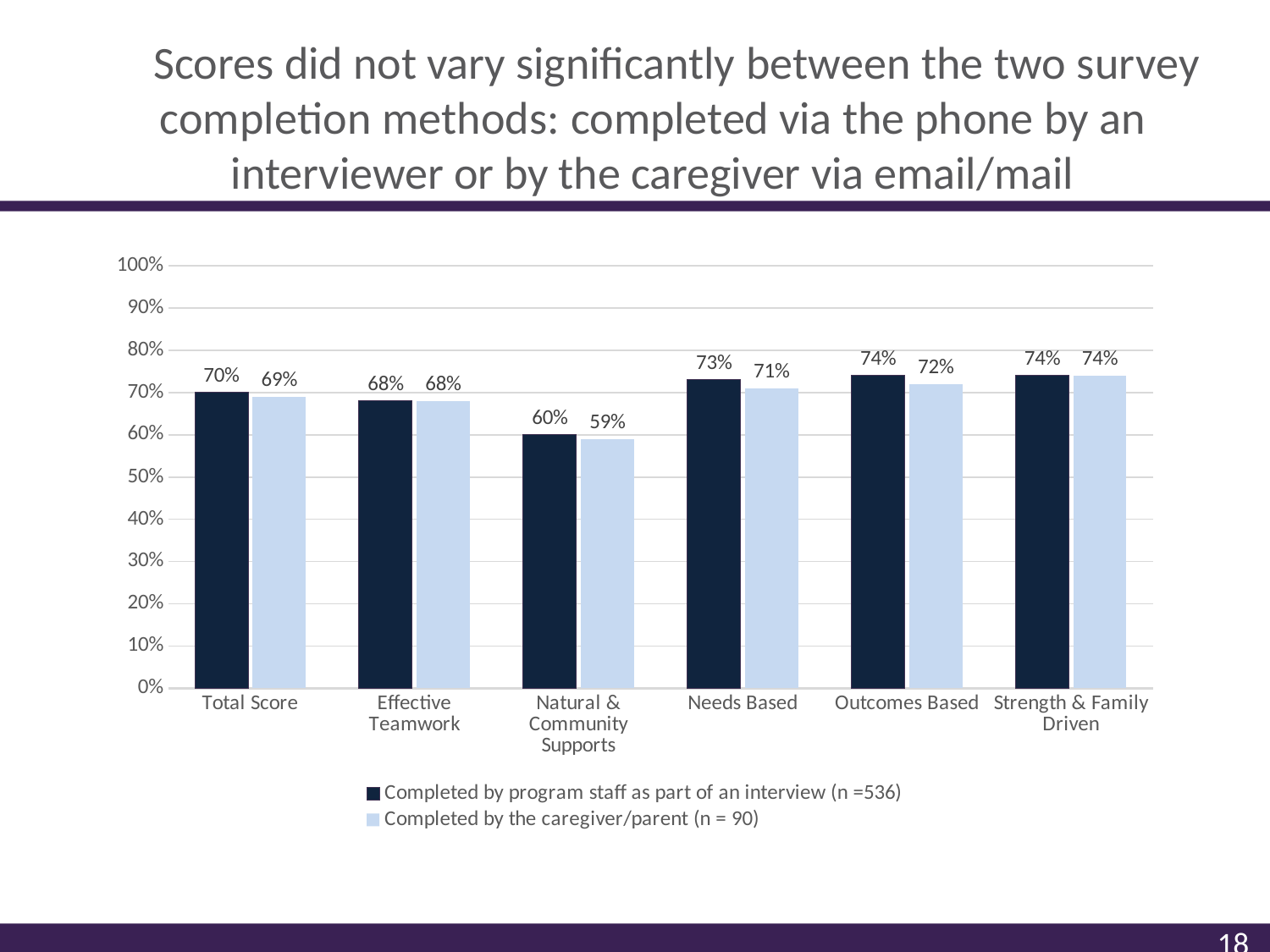
Is the program staff value for Natural & Community Supports greater or less than 50%? greater Which is larger for Outcomes Based: the program staff value or the caregiver/parent value? Program staff What is the value for Natural & Community Supports in the 'Completed by the caregiver/parent (n = 90)' series? 59% What is the difference between the program staff value and the caregiver/parent value for Needs Based? 2% What is the sample size (n) given in the legend for the caregiver/parent series? 90 What is the value for Outcomes Based in the 'Completed by the caregiver/parent (n = 90)' series? 72% How many series does the legend list? 2 Which category has the lowest value in the 'Completed by program staff as part of an interview (n =536)' series? Natural & Community Supports What is the value for Total Score in the 'Completed by program staff as part of an interview (n =536)' series? 70% What is the difference between the program staff value and the caregiver/parent value for Strength & Family Driven? 0% What kind of chart is shown on the slide? Bar chart How many categories are shown on the x axis? 6